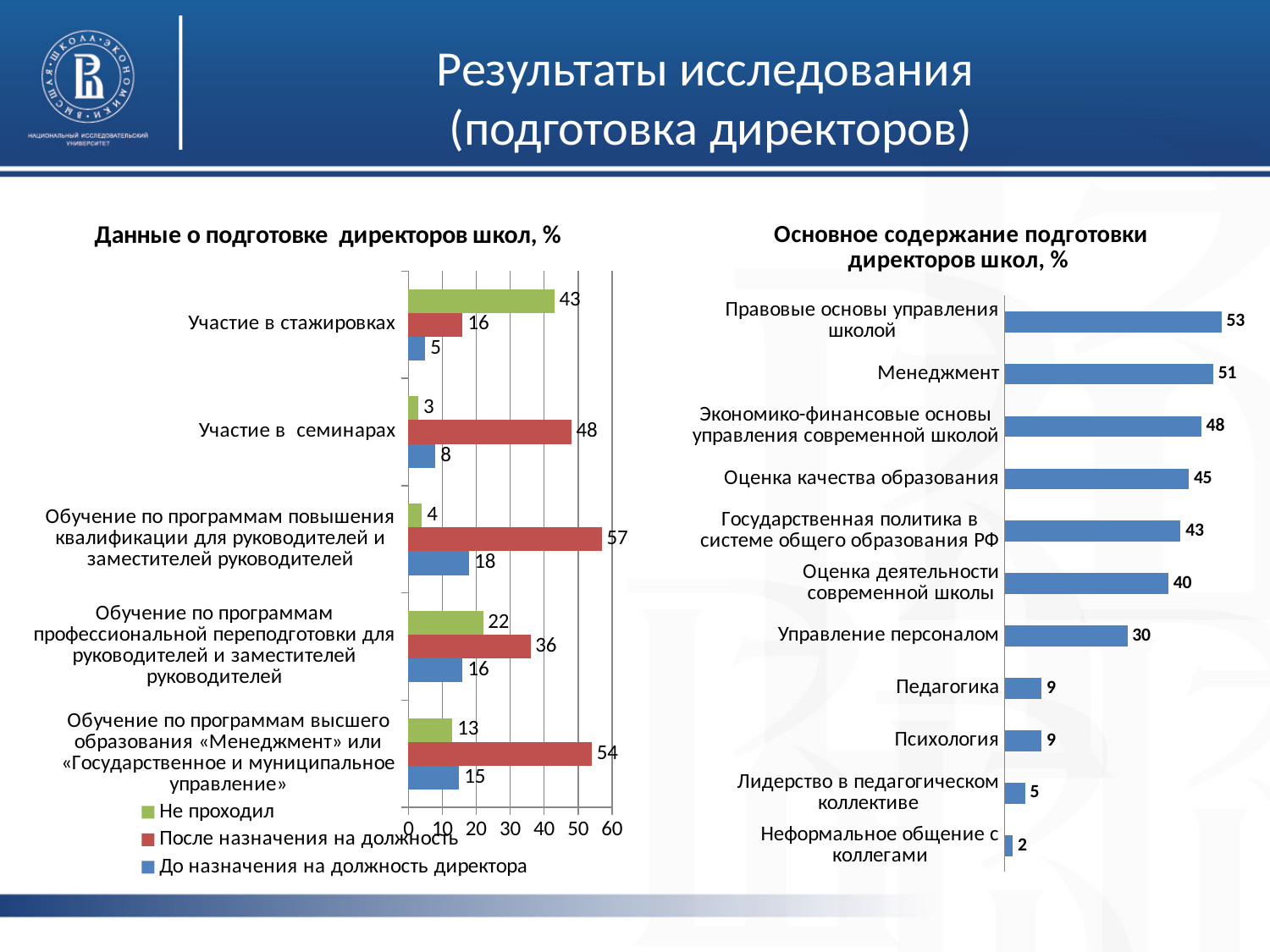
In the chart 'Основное содержание подготовки директоров школ, %', which category has the highest value? Правовые основы управления школой How many categories are shown in the chart 'Основное содержание подготовки директоров школ, %'? 11 In the chart 'Основное содержание подготовки директоров школ, %', what is the value for 'Менеджмент'? 51 In the chart 'Данные о подготовке директоров школ, %', which category has the highest value for 'После назначения на должность'? Обучение по программам повышения квалификации для руководителей и заместителей руководителей In the chart 'Данные о подготовке директоров школ, %', what is the value for 'После назначения на должность' in the category 'Участие в семинарах'? 48 In the chart 'Основное содержание подготовки директоров школ, %', what is the difference between 'Оценка качества образования' and 'Управление персоналом'? 15 In the chart 'Основное содержание подготовки директоров школ, %', which category has the lowest value? Неформальное общение с коллегами What type of chart is 'Основное содержание подготовки директоров школ, %'? Bar chart In the chart 'Данные о подготовке директоров школ, %', how many series does the legend list? 3 In the chart 'Данные о подготовке директоров школ, %', what is the difference between 'После назначения на должность' and 'До назначения на должность директора' for 'Обучение по программам повышения квалификации для руководителей и заместителей руководителей'? 39 In the chart 'Данные о подготовке директоров школ, %', what is the value for 'Не проходил' in the category 'Участие в стажировках'? 43 In the chart 'Данные о подготовке директоров школ, %', which is larger for 'Участие в стажировках': 'Не проходил' or 'До назначения на должность директора'? Не проходил